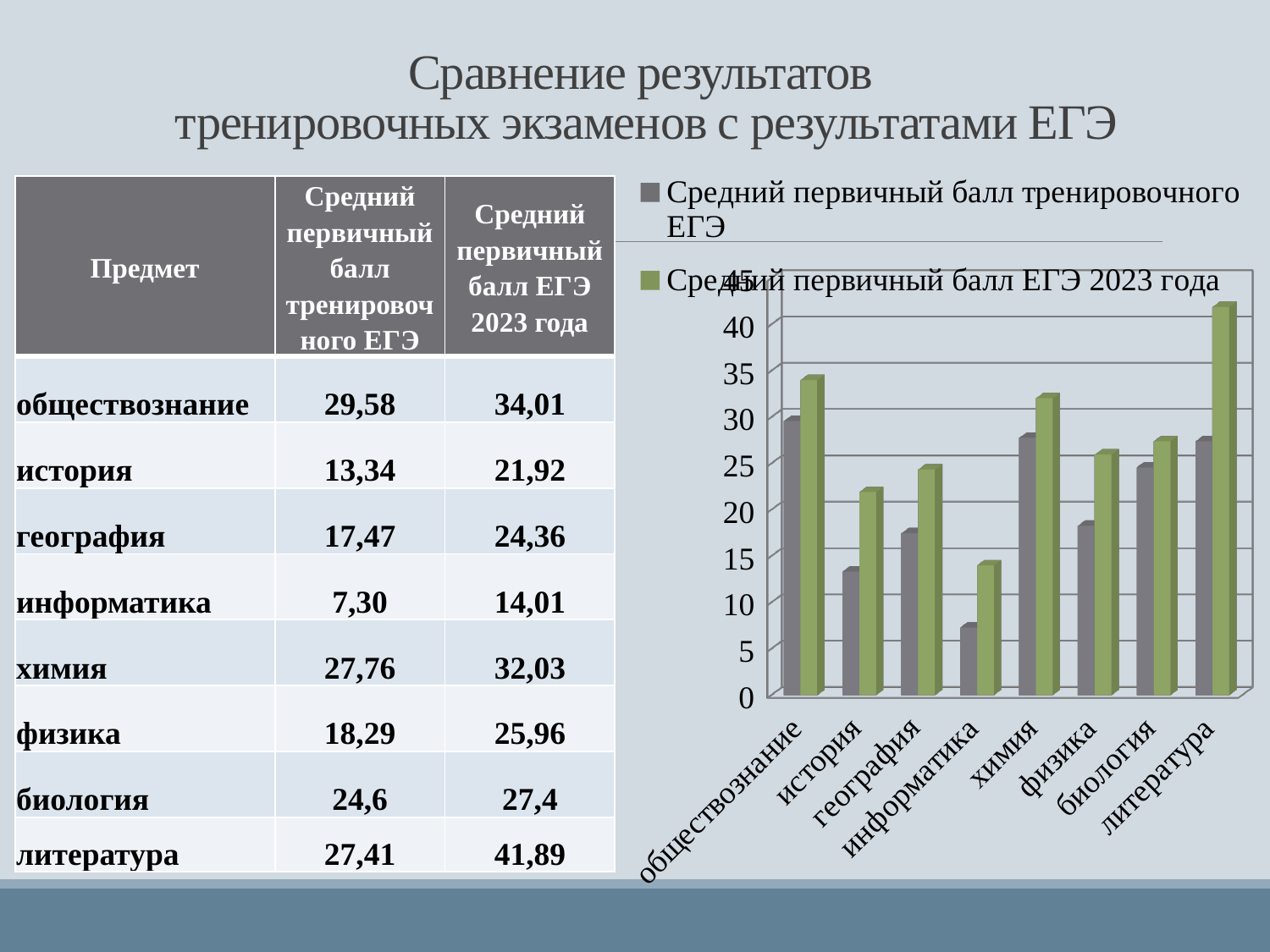
Which is larger: the ЕГЭ 2023 score for химия or the ЕГЭ 2023 score for физика? химия What is the difference between the ЕГЭ 2023 score and the training ЕГЭ score for литература? 14,48 What is the average primary score of the training ЕГЭ for информатика? 7,30 What is the average primary score of the training ЕГЭ for обществознание? 29,58 Which subject has the highest average primary score of the ЕГЭ 2023? литература What is the average primary score of the ЕГЭ 2023 for литература? 41,89 Which colour represents the series 'Средний первичный балл ЕГЭ 2023 года' in the chart? green How many series does the chart legend list? 2 What kind of chart is shown on the slide? bar chart How many subjects (categories) are plotted on the x axis of the chart? 8 Which subject has the lowest average primary score of the training ЕГЭ? информатика Is the ЕГЭ 2023 value for литература greater or less than 40? greater